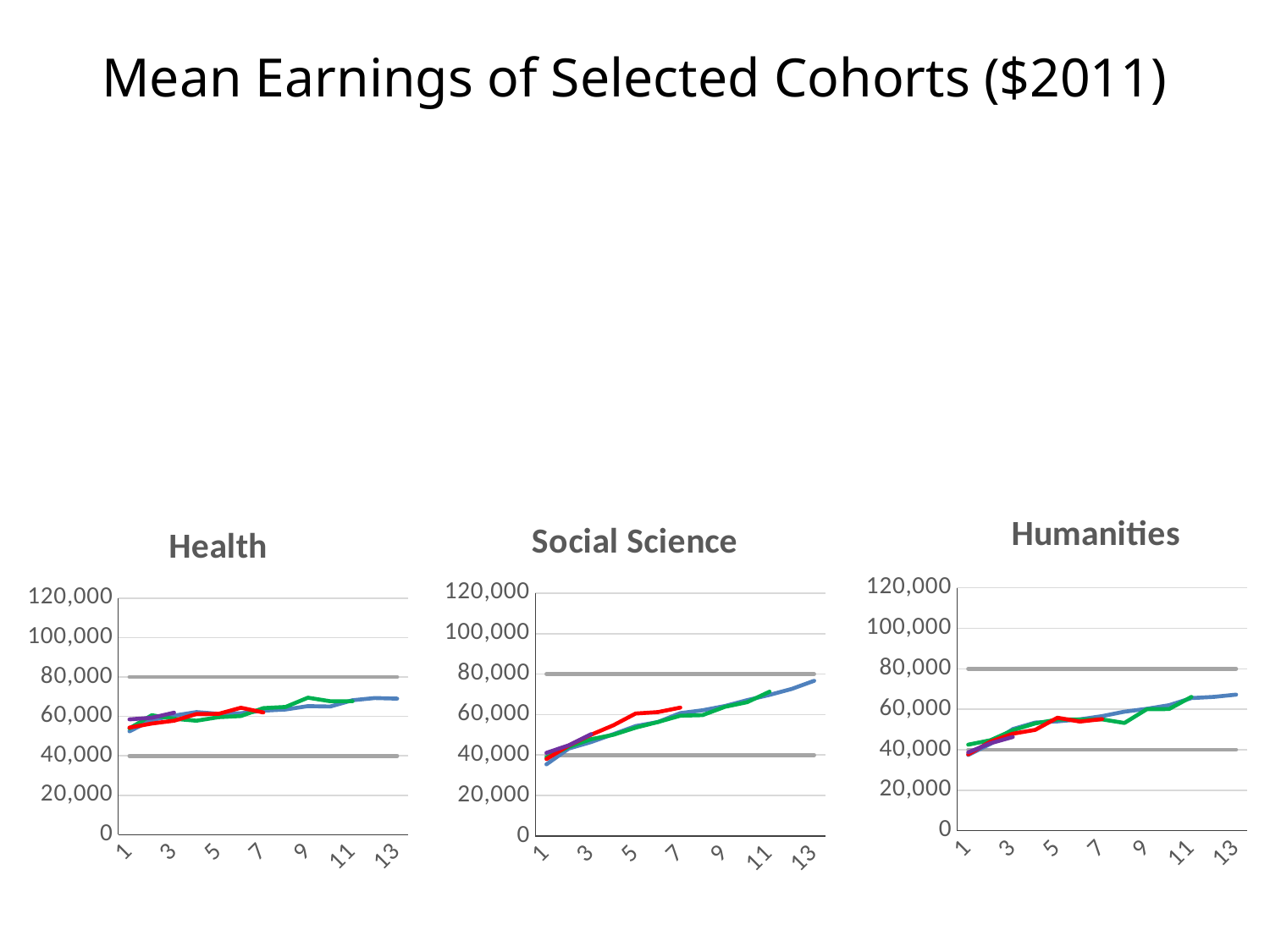
What type of chart is the Health chart? line chart In the Health chart, does the blue line rise or fall from x = 1 to x = 13? rise In the Humanities chart, is the value of the blue line at x = 13 greater or less than 60,000? greater In the Social Science chart, do the plotted lines generally rise or fall as x increases from 1 to 13? rise What is the highest value shown on the y axis of the Humanities chart? 120,000 What is the title of the slide? Mean Earnings of Selected Cohorts ($2011) In the Health chart, is the value of the blue line at x = 13 greater or less than 80,000? less In the Social Science chart, is the value of the blue line at x = 13 greater or less than 80,000? less How many charts are shown on the slide? 3